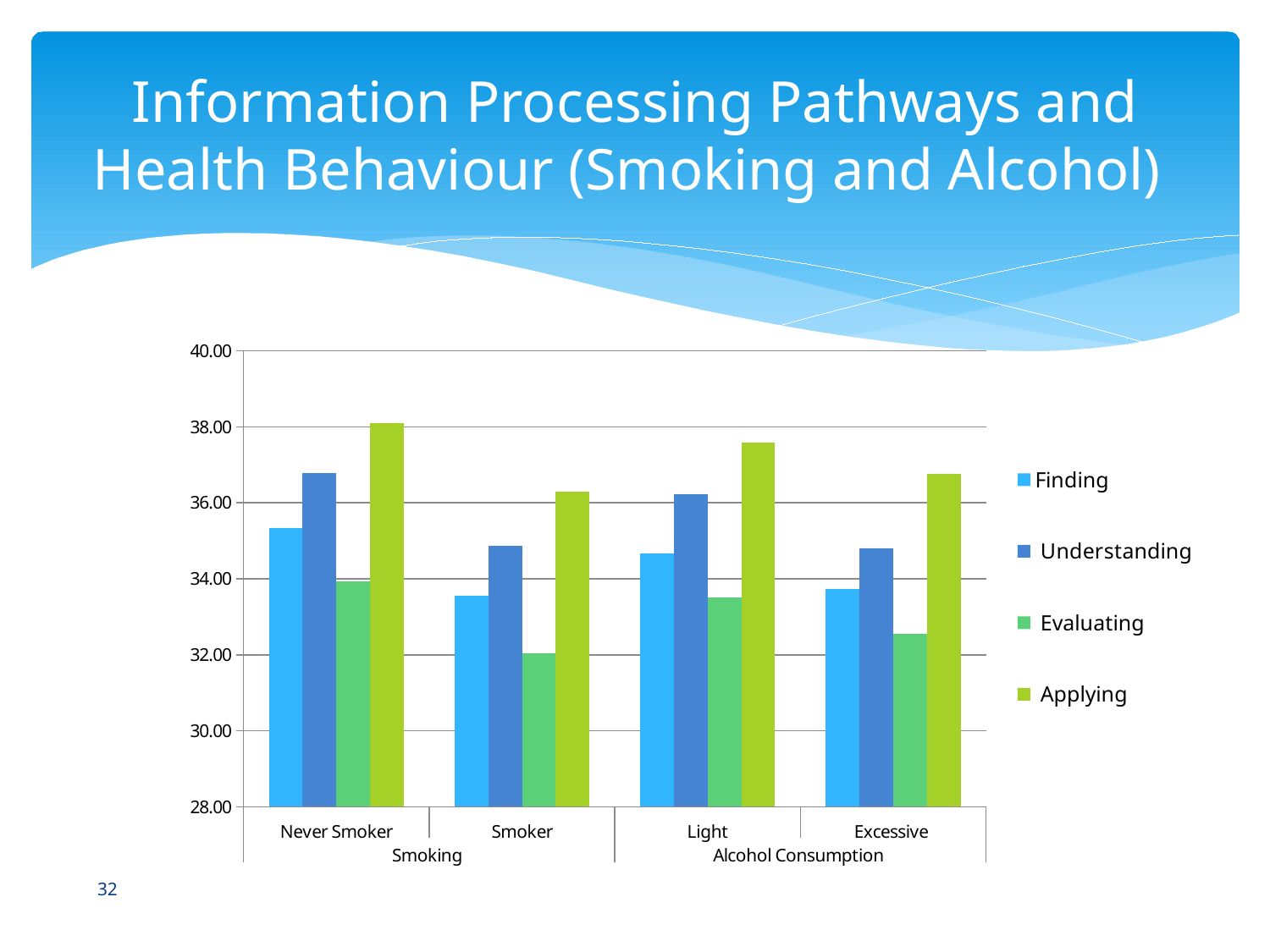
Is the Finding value for Light greater or less than 36? less For Never Smoker, which is larger: the Understanding value or the Finding value? Understanding How many categories are shown along the x axis? 4 What are the two group labels shown beneath the category labels on the x axis? Smoking and Alcohol Consumption Which category has the lowest Evaluating value? Smoker How many series does the legend list? 4 What kind of chart is shown on the slide? bar chart Which category has the highest Applying value? Never Smoker Is the Evaluating value for Smoker greater or less than 34? less Which series has the lowest bar in every category? Evaluating Is the Applying value for Never Smoker greater or less than 36? greater Which series has the highest bar in every category? Applying